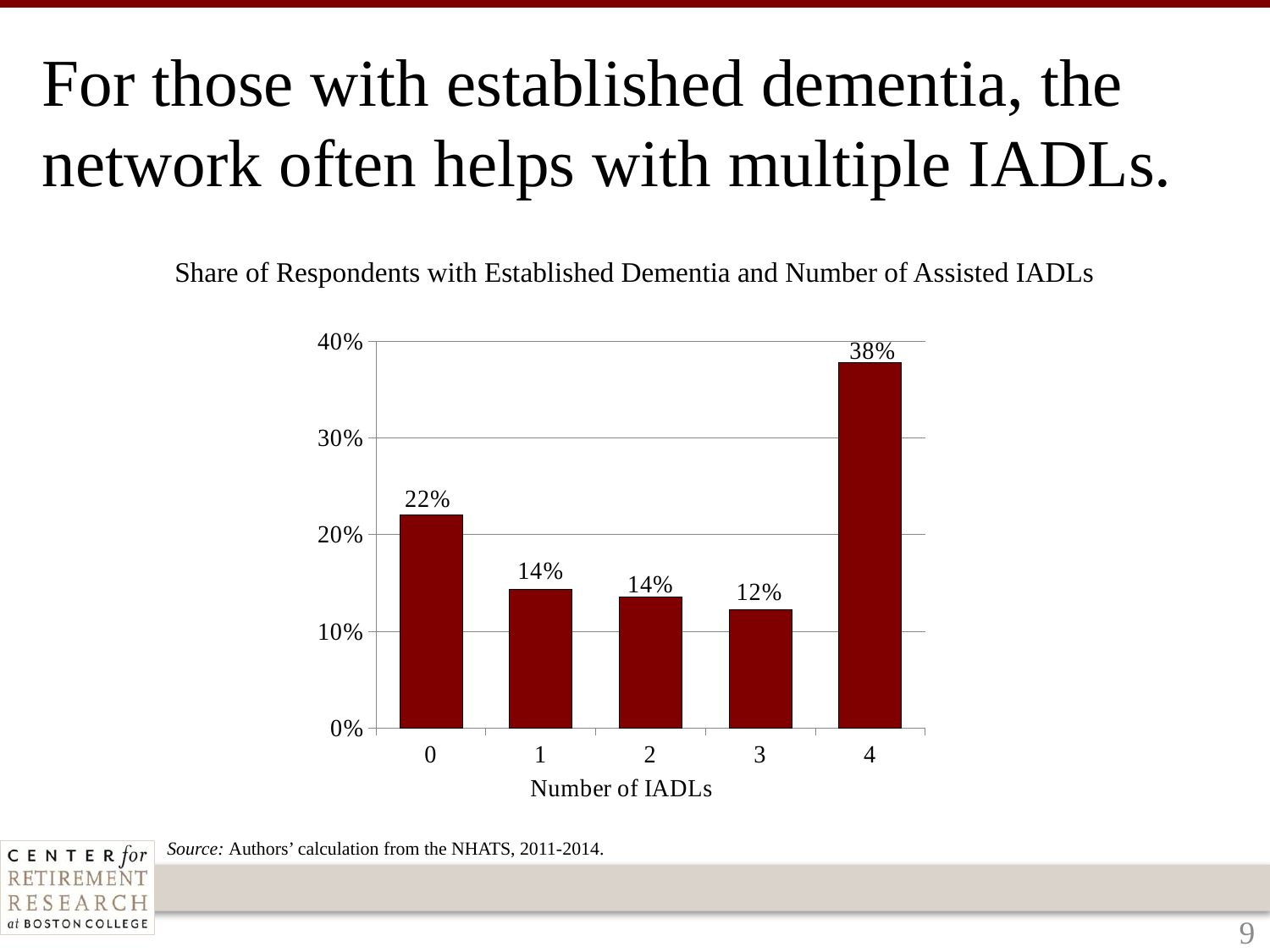
How many categories (numbers of IADLs) are shown on the x axis? 5 Which has a larger share of respondents: 0 IADLs or 1 IADL? 0 IADLs What is the label of the x axis? Number of IADLs What share of respondents with established dementia have 0 assisted IADLs? 22% Which number of IADLs has the highest share of respondents? 4 What kind of chart is shown on the slide? Bar chart What share of respondents with established dementia have 4 assisted IADLs? 38% Is the share for 3 IADLs greater or less than 20%? less Which number of IADLs has the lowest share of respondents? 3 What is the difference in share between 4 IADLs and 0 IADLs? 16% Is the share for 4 IADLs greater or less than 30%? greater What share of respondents with established dementia have 3 assisted IADLs? 12%